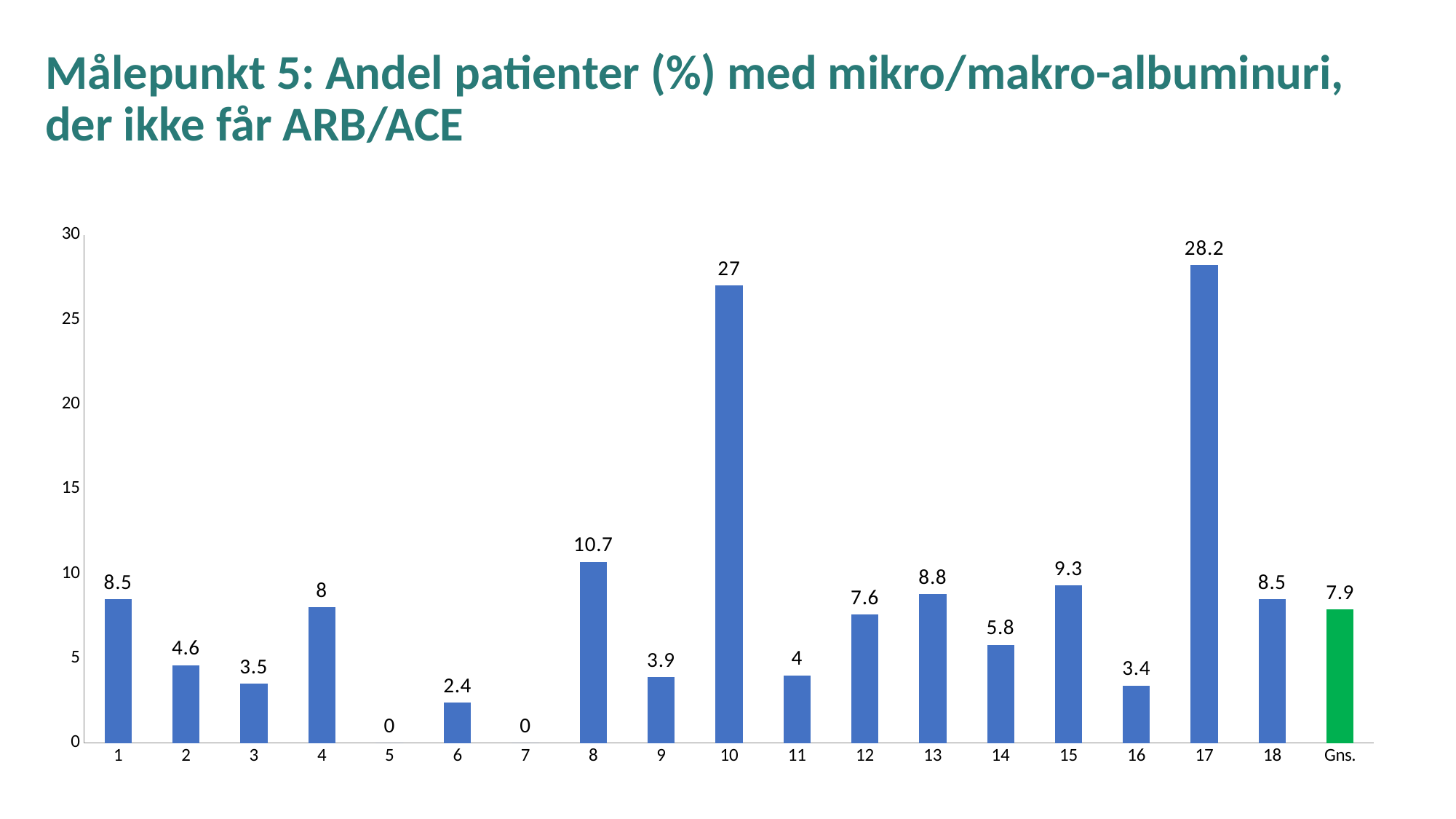
What is the value for category 8? 10.7 Which is larger, the value for category 8 or category 15? Category 8 What kind of chart is shown on the slide? Bar chart What is the difference between the values for category 17 and category 10? 1.2 Which bar is coloured green instead of blue? Gns. Is the value for category 10 greater or less than 25? greater What is the value for category 10? 27 What is the value for Gns.? 7.9 Which category has the highest value? 17 What is the value for category 16? 3.4 Which categories have a value of 0? 5 and 7 How many bars are shown on the x axis, including Gns.? 19